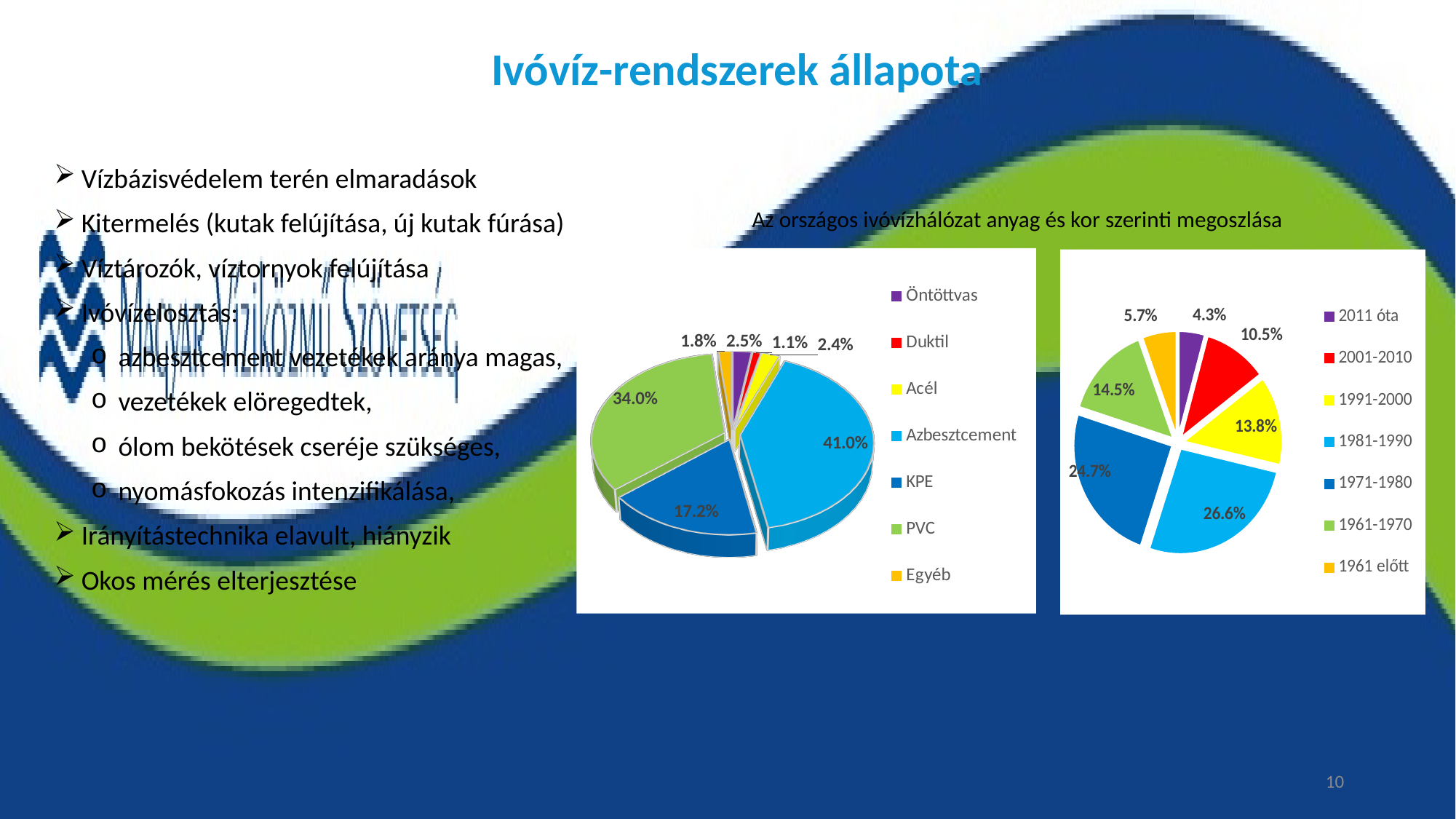
In the left pie chart, which material has the largest share? Azbesztcement What is the title shown above the two pie charts? Az országos ivóvízhálózat anyag és kor szerinti megoszlása In the left pie chart, what share does Azbesztcement have? 41.0% In the left pie chart, what is the difference between the shares of Azbesztcement and KPE? 23.8% In the right pie chart, which period has the largest share? 1981-1990 What kind of chart is the left chart on the slide? pie chart In the left pie chart, what share does PVC have? 34.0% In the left pie chart, which material has the smallest share? Duktil In the right pie chart, which is larger: 1961-1970 or 1991-2000? 1961-1970 How many entries does the legend of the left pie chart list? 7 In the right pie chart, what share does the 1981-1990 period have? 26.6% In the right pie chart, what share does the 2011 óta category have? 4.3%